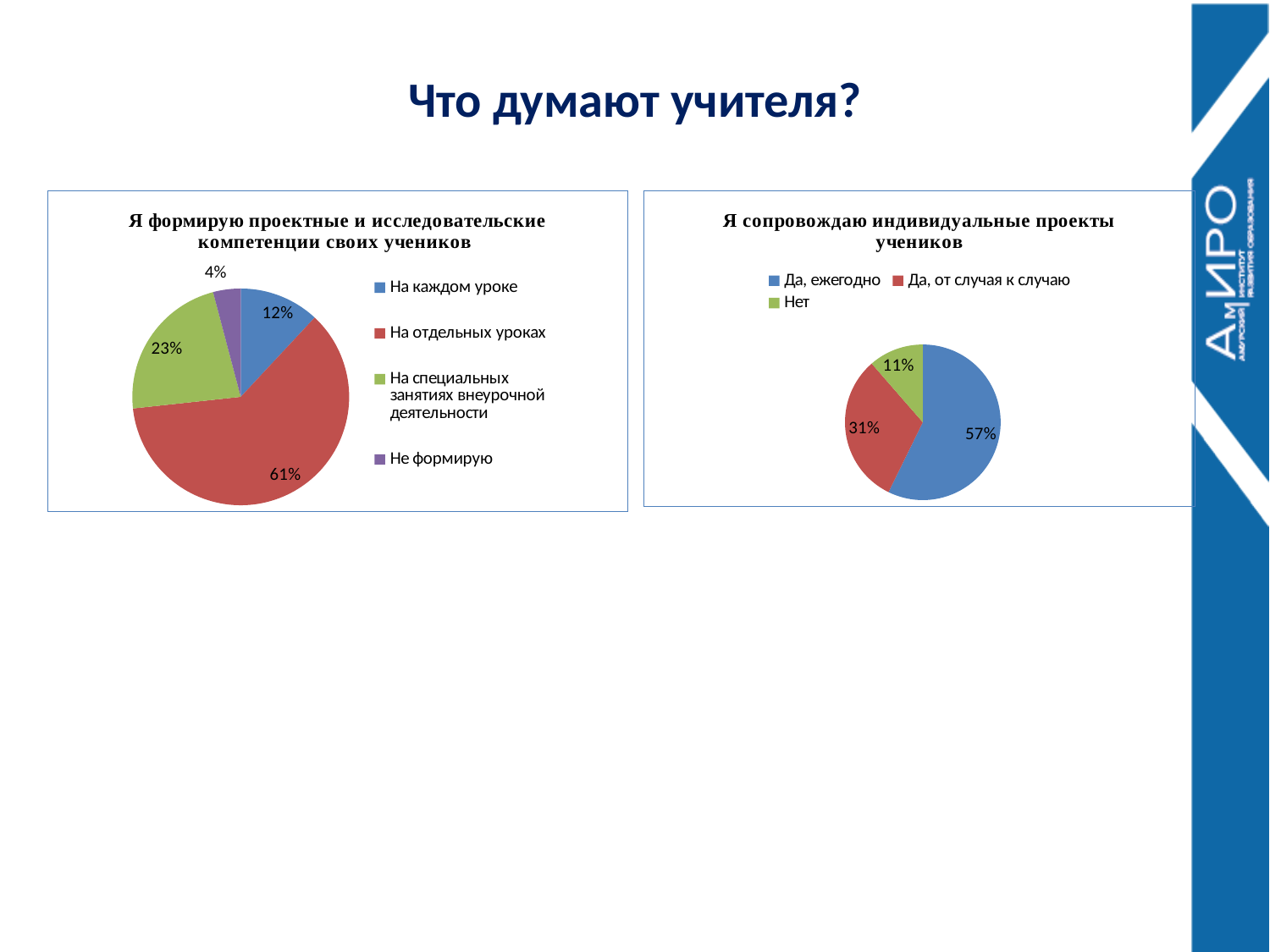
What kind of chart is the right chart 'Я сопровождаю индивидуальные проекты учеников'? Pie chart In the right chart 'Я сопровождаю индивидуальные проекты учеников', what share is labelled for 'Нет'? 11% In the left chart 'Я формирую проектные и исследовательские компетенции своих учеников', what is the difference between the shares for 'На специальных занятиях внеурочной деятельности' and 'На каждом уроке'? 11% In the left chart 'Я формирую проектные и исследовательские компетенции своих учеников', what share is labelled for 'Не формирую'? 4% In the right chart 'Я сопровождаю индивидуальные проекты учеников', what is the difference between the shares for 'Да, ежегодно' and 'Да, от случая к случаю'? 26% In the left chart 'Я формирую проектные и исследовательские компетенции своих учеников', what share is labelled for 'На каждом уроке'? 12% In the right chart 'Я сопровождаю индивидуальные проекты учеников', what share is labelled for 'Да, ежегодно'? 57% In the left chart 'Я формирую проектные и исследовательские компетенции своих учеников', what share is labelled for 'На отдельных уроках'? 61% In the left chart 'Я формирую проектные и исследовательские компетенции своих учеников', which category has the largest slice? На отдельных уроках In the left chart 'Я формирую проектные и исследовательские компетенции своих учеников', how many categories does the legend list? 4 In the left chart 'Я формирую проектные и исследовательские компетенции своих учеников', which category has the smallest slice? Не формирую In the right chart 'Я сопровождаю индивидуальные проекты учеников', which is larger: 'Да, от случая к случаю' or 'Нет'? Да, от случая к случаю